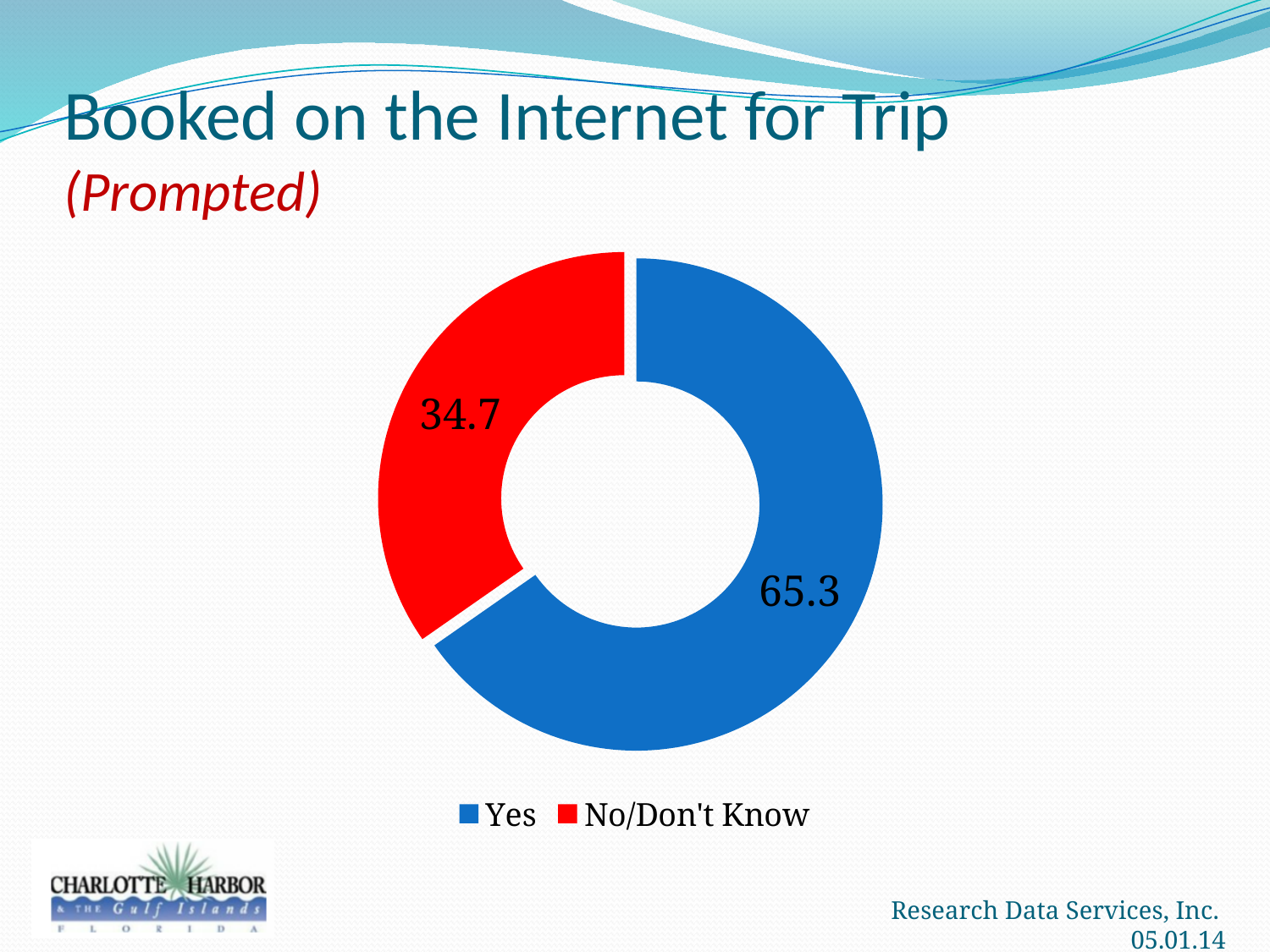
How many entries does the legend list? 2 What is the value for Yes? 65.3 What colour represents the Yes category? Blue What is the total of the two values shown? 100 How many categories are shown in the chart? 2 Which category has the largest share? Yes What is the title of the slide? Booked on the Internet for Trip (Prompted) What is the difference between the Yes and No/Don't Know values? 30.6 Which category has the smallest share? No/Don't Know What is the value for No/Don't Know? 34.7 Which is larger, Yes or No/Don't Know? Yes What kind of chart is shown on the slide? Doughnut (pie) chart